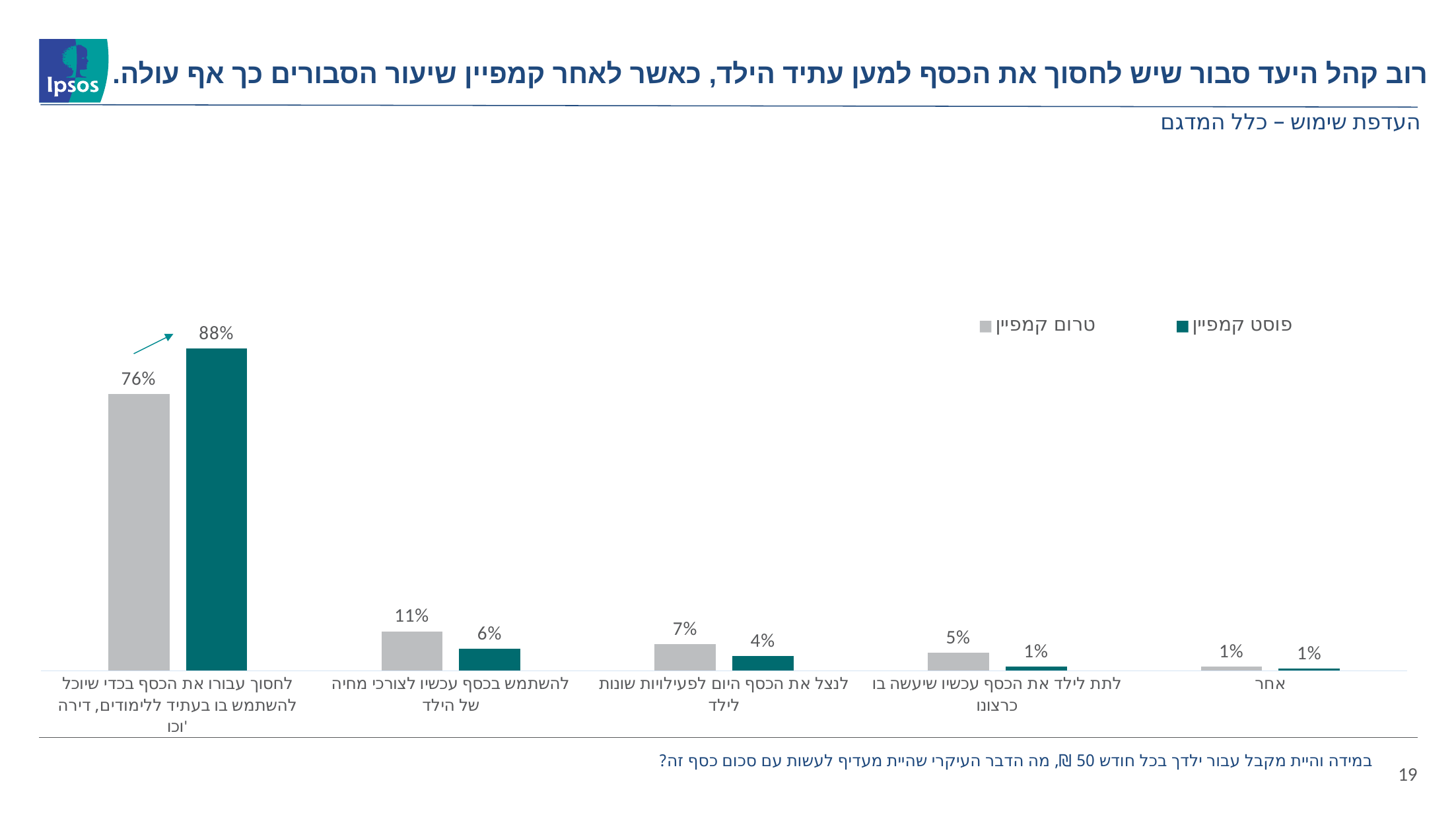
What kind of chart is shown on the slide? Bar chart Which series is shown in teal in the chart? פוסט קמפיין How many categories are shown on the x axis of the chart? 5 What is the value for "פוסט קמפיין" in the category "לחסוך עבורו את הכסף בכדי שיוכל להשתמש בו בעתיד ללימודים, דירה וכו'"? 88% What is the value for "טרום קמפיין" in the category "להשתמש בכסף עכשיו לצורכי מחיה של הילד"? 11% How many series does the legend list? 2 What is the difference between the "פוסט קמפיין" and "טרום קמפיין" values in the category "לחסוך עבורו את הכסף בכדי שיוכל להשתמש בו בעתיד ללימודים, דירה וכו'"? 12% In the category "לתת לילד את הכסף עכשיו שיעשה בו כרצונו", which series has the larger value, "טרום קמפיין" or "פוסט קמפיין"? טרום קמפיין What is the difference between the "טרום קמפיין" and "פוסט קמפיין" values in the category "להשתמש בכסף עכשיו לצורכי מחיה של הילד"? 5% What is the value for "פוסט קמפיין" in the category "לנצל את הכסף היום לפעילויות שונות לילד"? 4% Which category has the highest value for "פוסט קמפיין"? לחסוך עבורו את הכסף בכדי שיוכל להשתמש בו בעתיד ללימודים, דירה וכו' What is the value for "טרום קמפיין" in the category "לתת לילד את הכסף עכשיו שיעשה בו כרצונו"? 5%